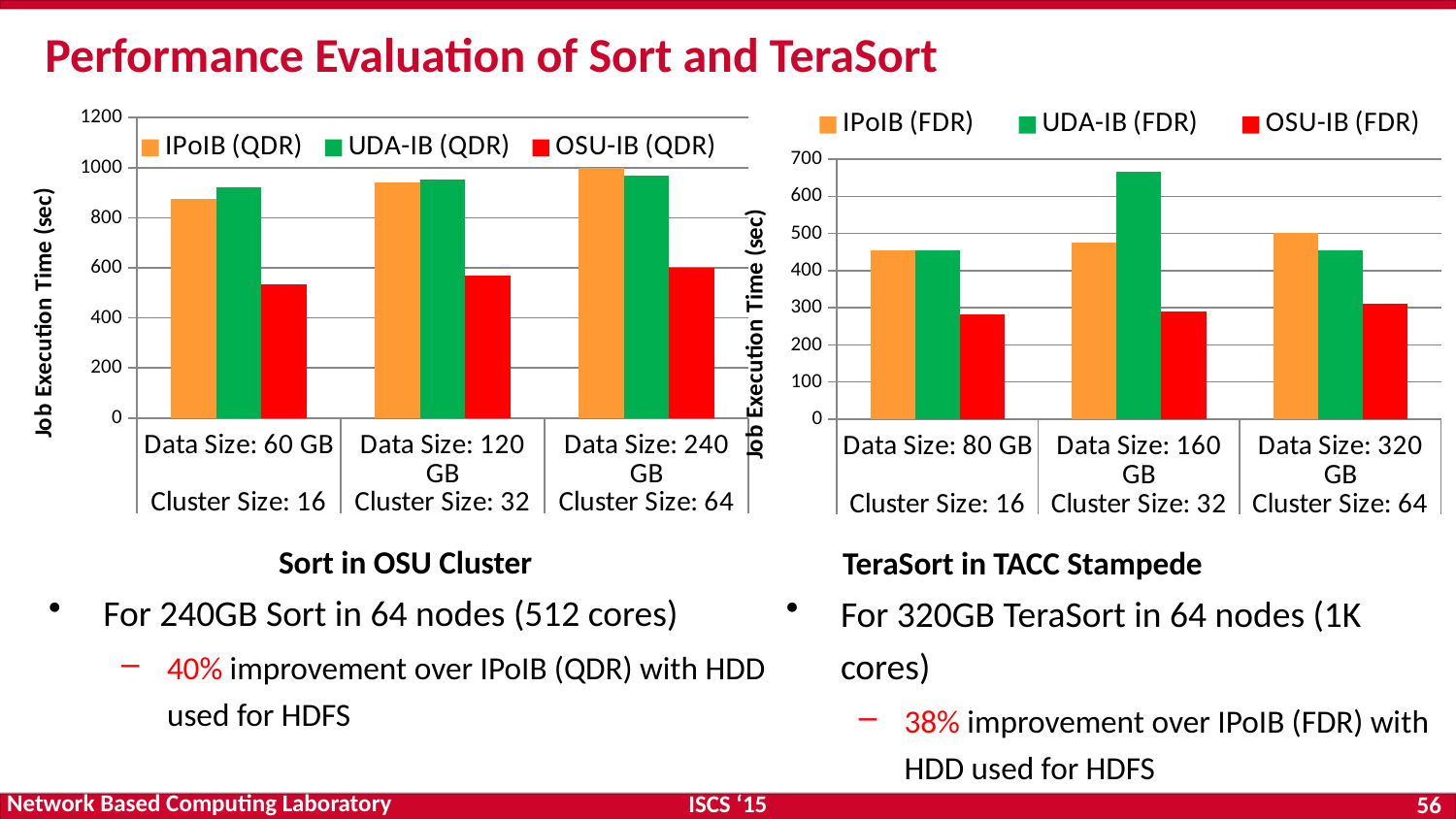
In the Sort in OSU Cluster chart, how many data size / cluster size categories are shown on the x axis? 3 In the Sort in OSU Cluster chart, is the OSU-IB (QDR) value for Data Size: 60 GB, Cluster Size: 16 greater or less than 600? less In the Sort in OSU Cluster chart, for Data Size: 60 GB, Cluster Size: 16, which is larger: IPoIB (QDR) or OSU-IB (QDR)? IPoIB (QDR) In the TeraSort in TACC Stampede chart, which series has the highest value for Data Size: 160 GB, Cluster Size: 32? UDA-IB (FDR) In the Sort in OSU Cluster chart, how many series does the legend list? 3 In the Sort in OSU Cluster chart, is the IPoIB (QDR) value for Data Size: 240 GB, Cluster Size: 64 greater or less than 800? greater In the TeraSort in TACC Stampede chart, is the IPoIB (FDR) value for Data Size: 80 GB, Cluster Size: 16 greater or less than 400? greater In the TeraSort in TACC Stampede chart, what are the three legend entries? IPoIB (FDR), UDA-IB (FDR), OSU-IB (FDR) In the Sort in OSU Cluster chart, what kind of chart is shown? bar chart In the TeraSort in TACC Stampede chart, which series has the lowest value for Data Size: 320 GB, Cluster Size: 64? OSU-IB (FDR) In the Sort in OSU Cluster chart, do the IPoIB (QDR) values rise or fall as data size increases along the x axis? rise